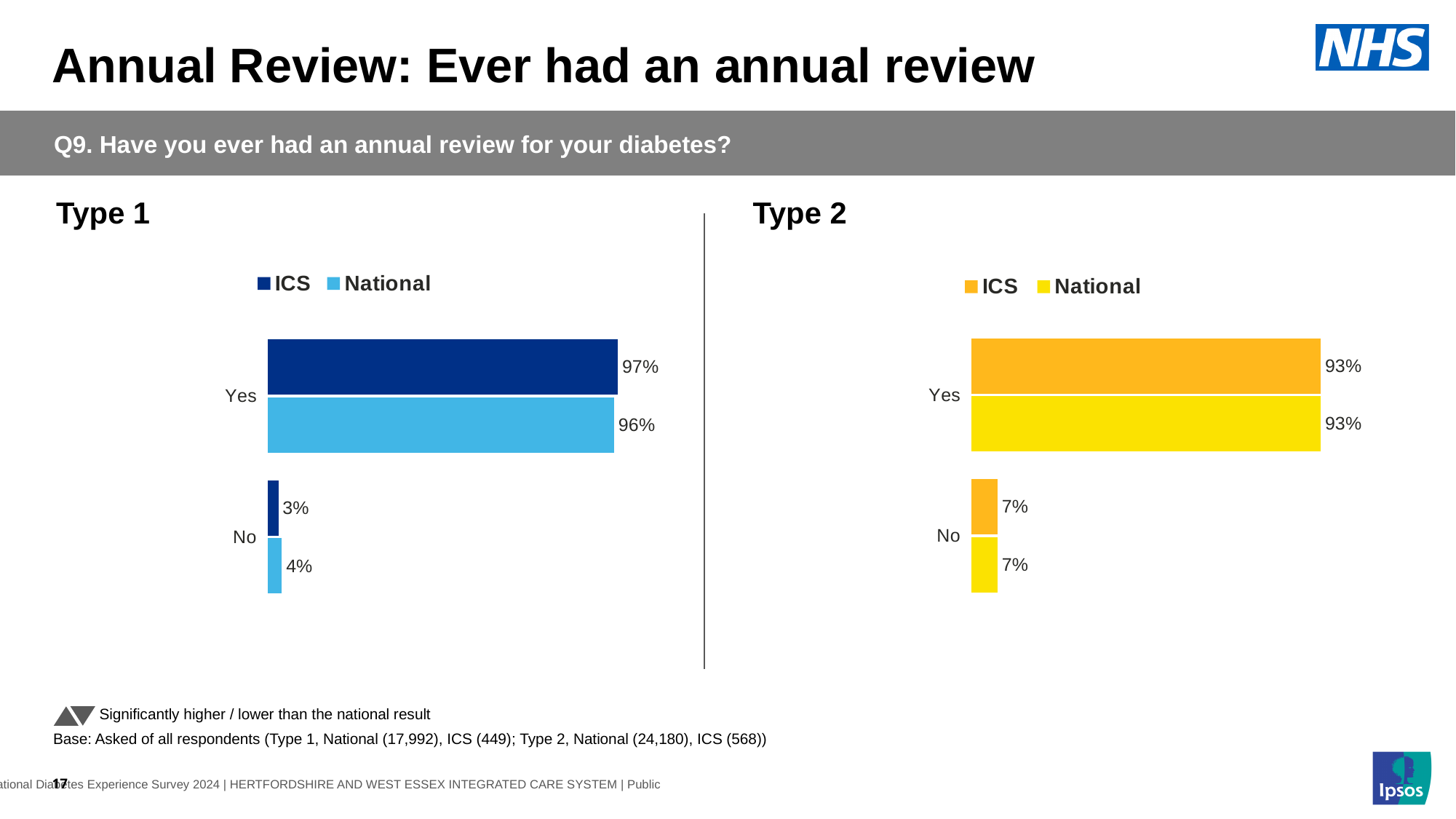
In the Type 2 chart, what is the National value for No? 7% In the Type 2 chart, what is the ICS value for Yes? 93% In the Type 1 chart, what is the ICS value for Yes? 97% In the Type 2 chart, what is the difference between the ICS and National values for No? 0 percentage points In the Type 1 chart, which category has the highest ICS value? Yes In the Type 1 chart, what is the difference between the ICS and National values for Yes? 1 percentage point In the Type 2 chart, which category has the lowest National value? No In the Type 1 chart, what is the National value for No? 4% How many categories are shown in the Type 2 chart? 2 How many series does the legend of the Type 1 chart list? 2 In the Type 1 chart, which is larger for No: the ICS value or the National value? National What kind of chart is the Type 2 chart? Bar chart